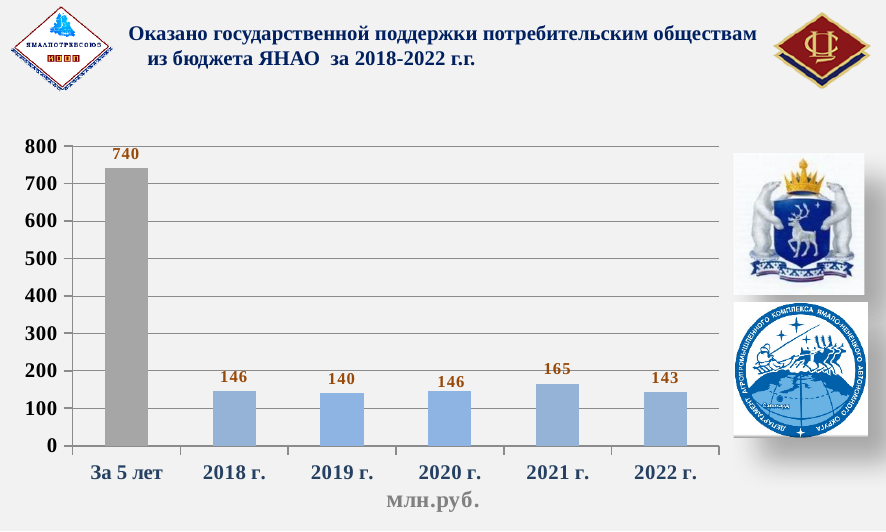
What is the value for 2018 г.? 146 Among the yearly bars (2018–2022), which year has the highest value? 2021 г. What is the value for 2021 г.? 165 What is the value for the 'За 5 лет' bar? 740 What unit is indicated below the x axis of the chart? млн.руб. How many bars are plotted in the chart? 6 What is the difference between the values for 2021 г. and 2022 г.? 22 Is the value for 2021 г. greater or less than 200? less What type of chart is shown on the slide? bar chart Among the yearly bars (2018–2022), which year has the lowest value? 2019 г. What is the value for 2019 г.? 140 Which is larger, the value for 2020 г. or the value for 2019 г.? 2020 г.